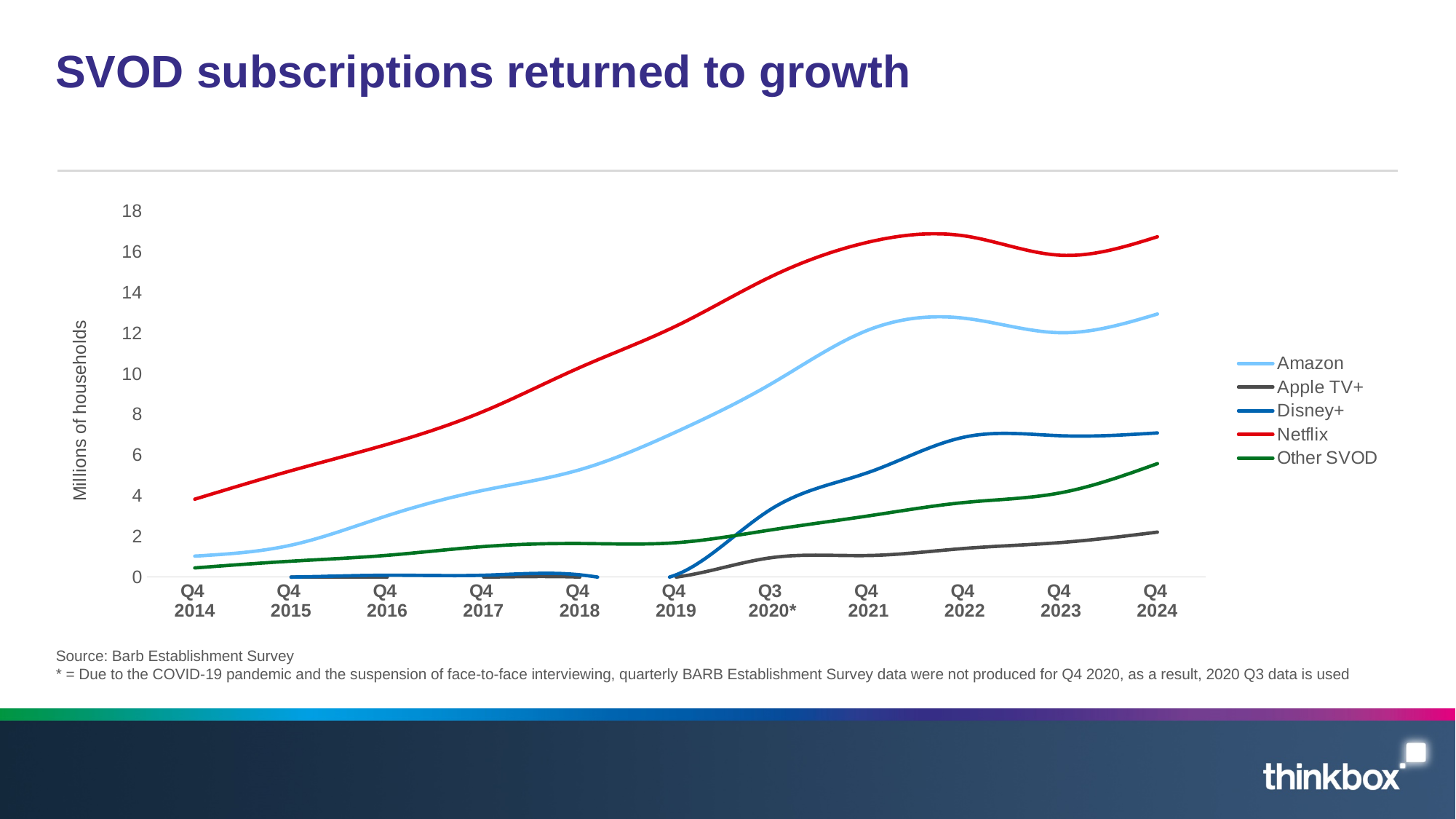
Does the Netflix line rise or fall between Q4 2014 and Q4 2022? Rises Which series has the lowest value at Q4 2024? Apple TV+ Which series has the highest value at Q4 2024? Netflix Which is larger at Q4 2024, Disney+ or Other SVOD? Disney+ Is the value for Netflix at Q4 2024 greater or less than 16? greater Is the value for Apple TV+ at Q4 2024 greater or less than 4? less What is the label on the y axis? Millions of households What kind of chart is shown on the slide? Line chart How many series does the legend list? 5 How many time points are shown on the x axis? 11 Is the value for Amazon at Q4 2024 greater or less than 12? greater